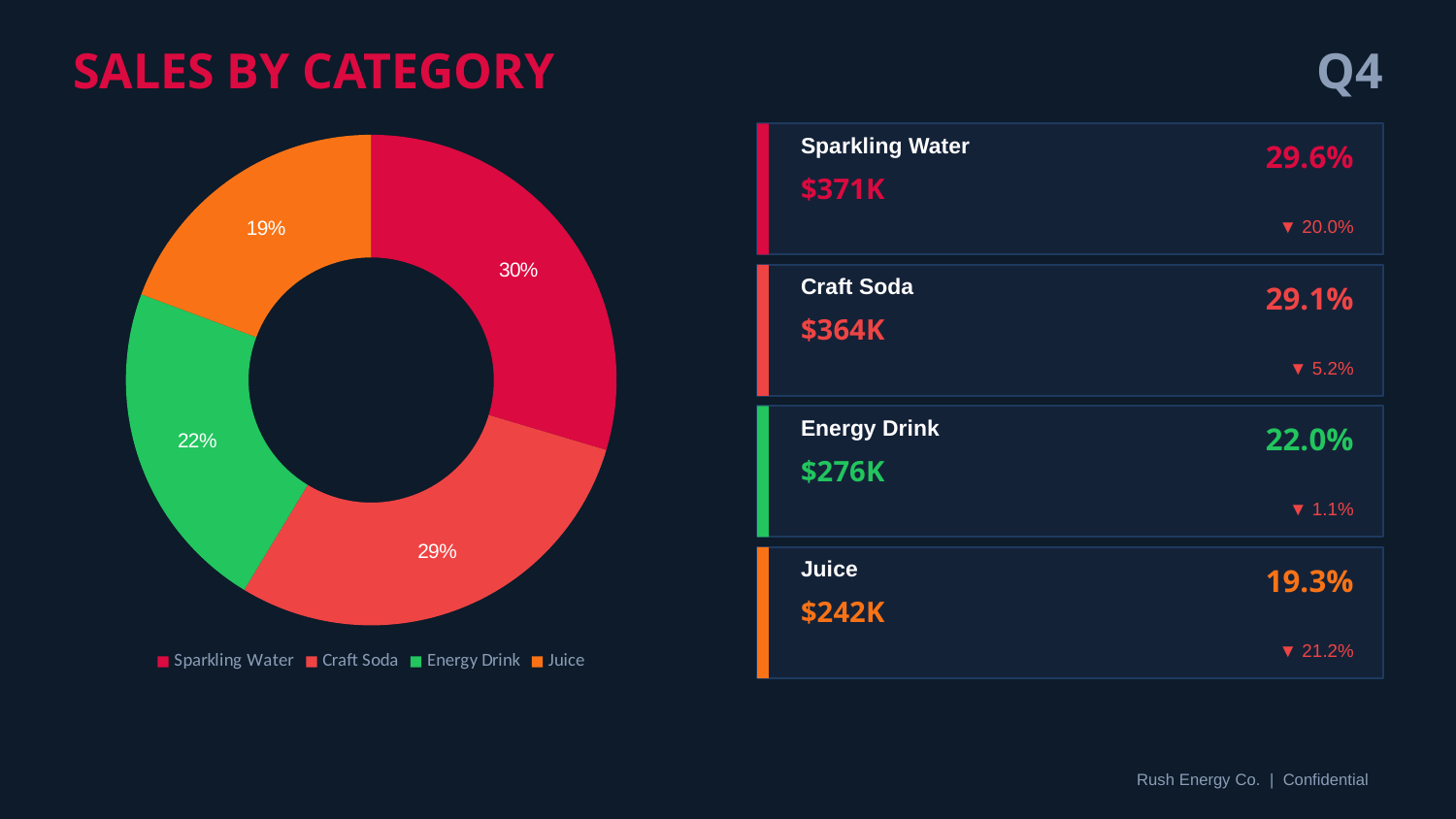
How many categories are shown in the pie chart? 4 What kind of chart is shown on the slide? Doughnut (pie) chart What percentage share does the Juice slice show in the pie chart? 19% What percentage share does the Energy Drink slice show in the pie chart? 22% What is the difference in percentage points between the Energy Drink slice and the Juice slice? 3 Which slice is larger in the pie chart, Energy Drink or Juice? Energy Drink What percentage share does the Craft Soda slice show in the pie chart? 29% What percentage share does the Sparkling Water slice show in the pie chart? 30% Which category has the largest slice in the pie chart? Sparkling Water What is the difference in percentage points between the Sparkling Water slice and the Juice slice? 11 Which category has the smallest slice in the pie chart? Juice What is the title of the slide containing the chart? SALES BY CATEGORY